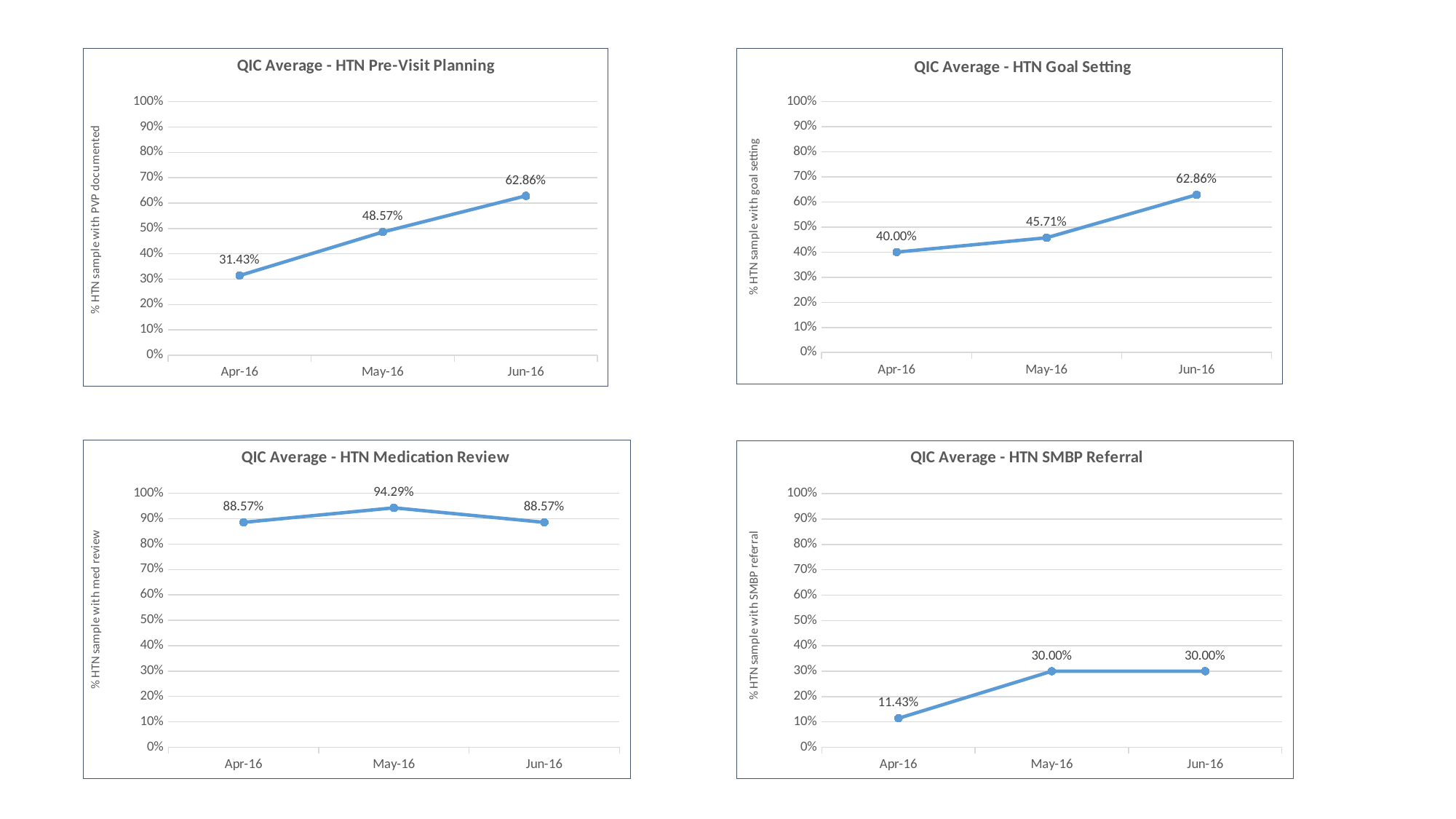
In the 'QIC Average - HTN Pre-Visit Planning' chart, do the values rise or fall from Apr-16 to Jun-16? rise What kind of chart is 'QIC Average - HTN Goal Setting'? line chart In the 'QIC Average - HTN Pre-Visit Planning' chart, what is the value for Apr-16? 31.43% How many data points are plotted in the 'QIC Average - HTN Medication Review' chart? 3 In the 'QIC Average - HTN Goal Setting' chart, what is the value for May-16? 45.71% In the 'QIC Average - HTN SMBP Referral' chart, which month has the lowest value? Apr-16 In the 'QIC Average - HTN Pre-Visit Planning' chart, what is the difference between the Jun-16 and Apr-16 values? 31.43% What is the y-axis label of the 'QIC Average - HTN Medication Review' chart? % HTN sample with med review In the 'QIC Average - HTN Medication Review' chart, which month has the highest value? May-16 In the 'QIC Average - HTN SMBP Referral' chart, is the value for Apr-16 greater or less than 20%? less In the 'QIC Average - HTN SMBP Referral' chart, what is the value for Jun-16? 30.00% In the 'QIC Average - HTN Goal Setting' chart, is the value for Apr-16 or Jun-16 larger? Jun-16